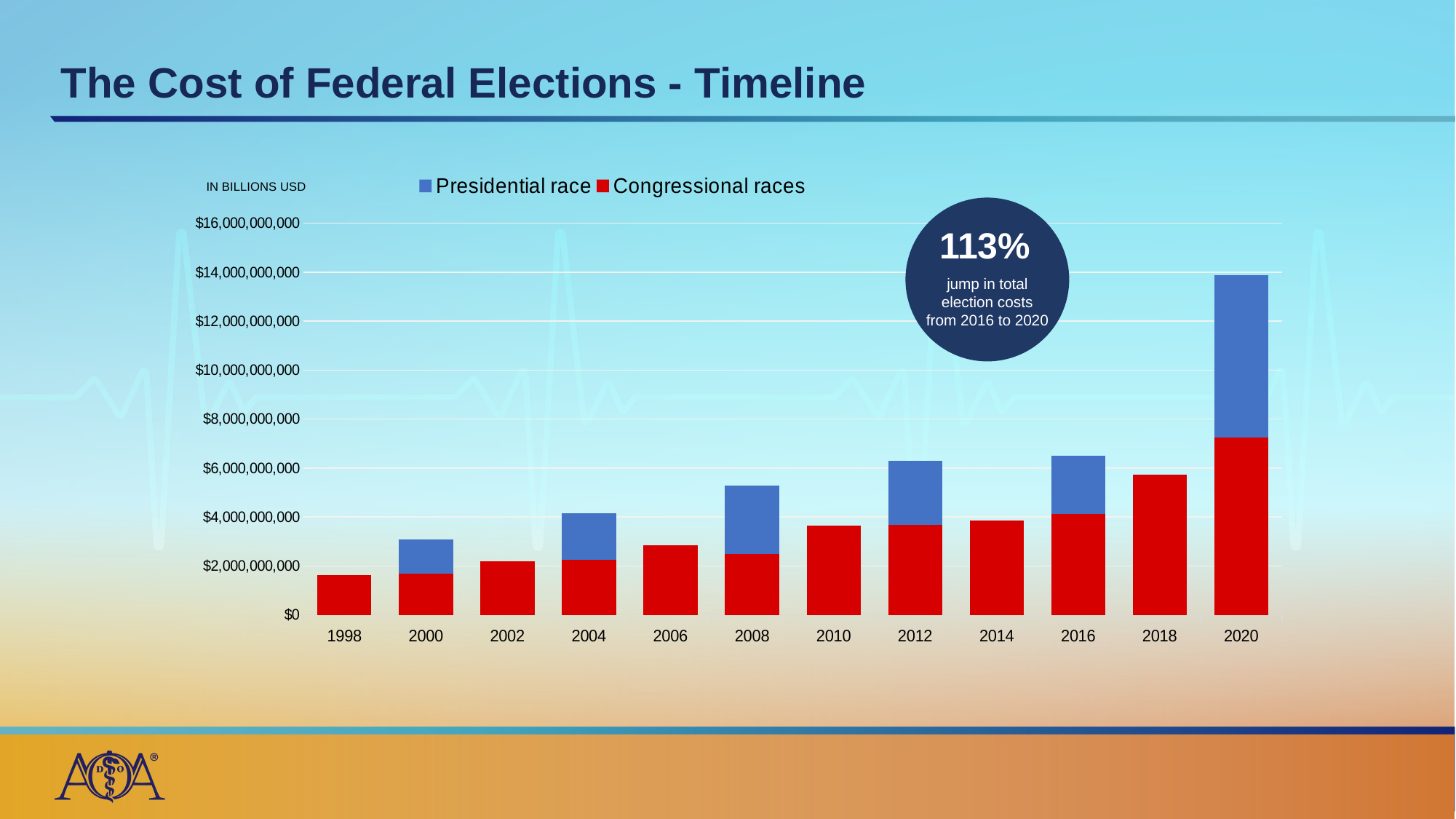
Which year has the larger Congressional races value, 2014 or 2018? 2018 Which year has the lowest total election cost? 1998 Which series is shown in blue in the legend? Presidential race Is the Congressional races value for 2018 greater or less than $6,000,000,000? less Which year has the highest total election cost? 2020 Is the Congressional races value for 2020 greater or less than $6,000,000,000? greater Is the total election cost for 2020 greater or less than $12,000,000,000? greater What kind of chart is shown on the slide? bar chart How many years are shown along the x axis? 12 How many series does the legend list? 2 Do total election costs generally rise or fall from 1998 to 2020? rise